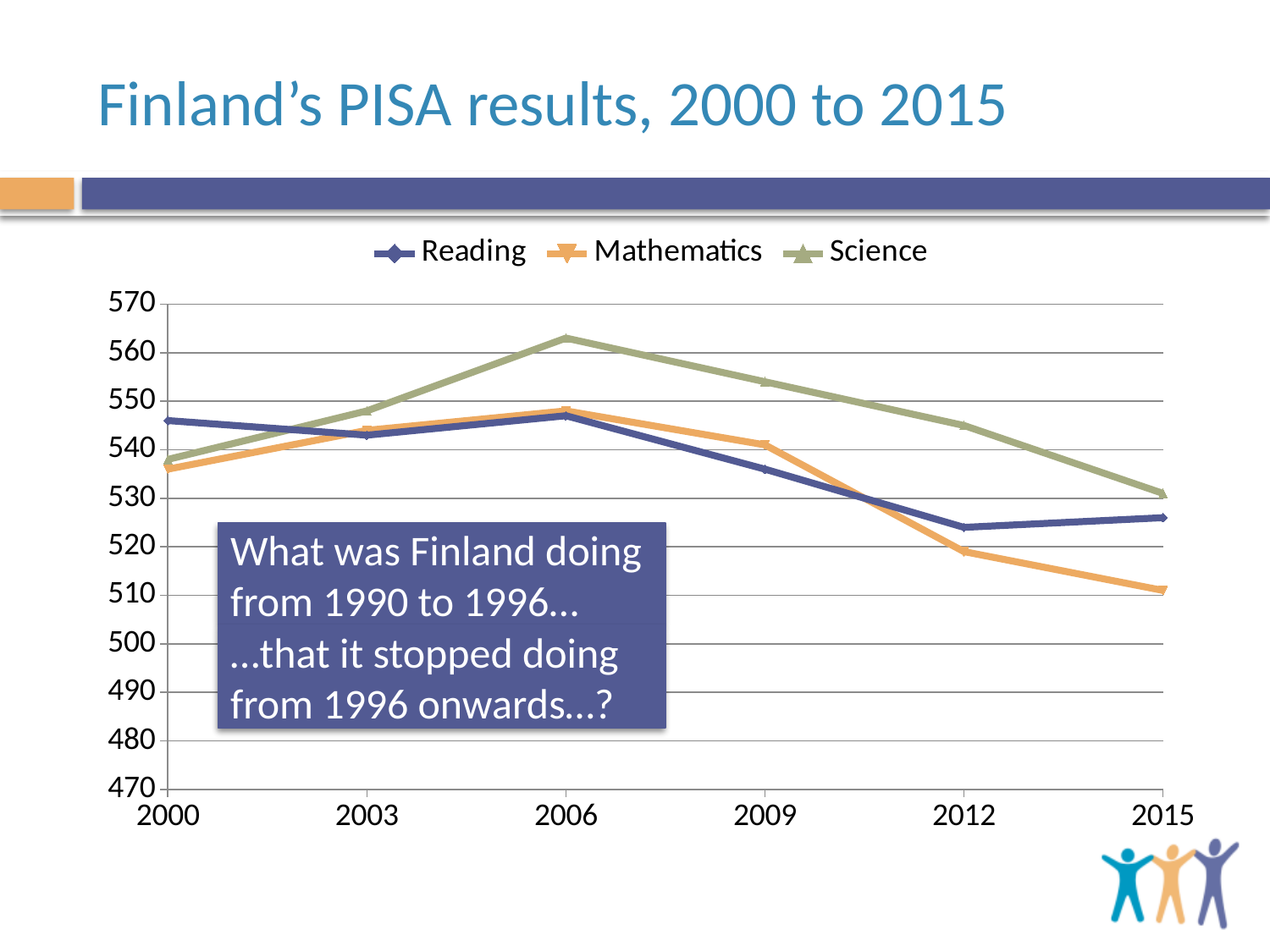
In which year does the Mathematics line reach its lowest value? 2015 How many years are plotted along the x axis? 6 Is the Reading value for 2012 greater or less than 530? less Is the Science value for 2006 greater or less than 560? greater How many series does the legend list? 3 Which series has the lowest value in 2015? Mathematics Is the Science value for 2012 greater or less than 540? greater Does the Mathematics line rise or fall from 2006 to 2015? fall What kind of chart is shown on the slide? line chart In which year does the Science line reach its highest value? 2006 In 2006, which is larger: the Science value or the Mathematics value? Science